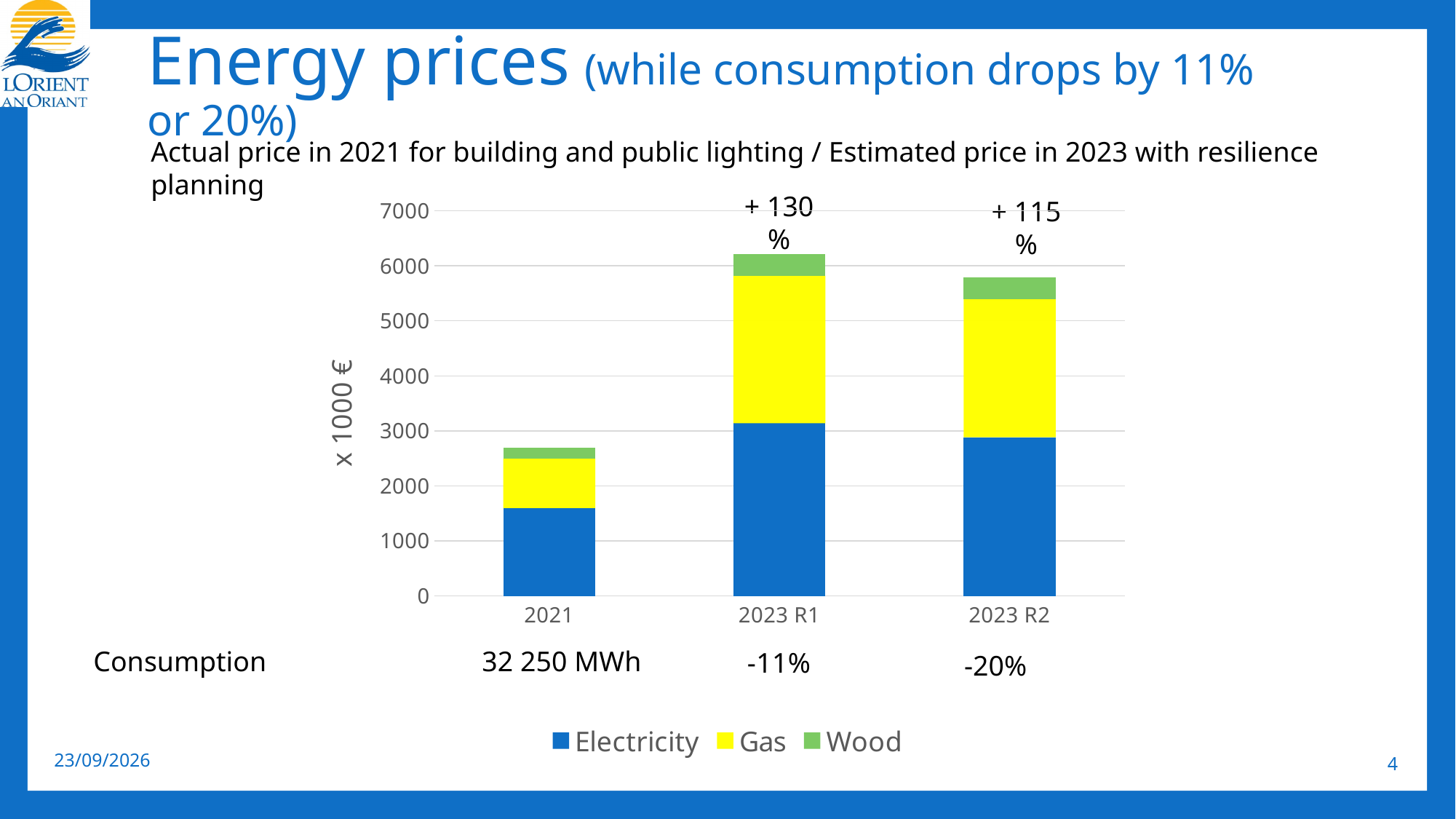
What percentage increase is printed above the 2023 R1 bar? + 130 % Is the total bar for 2023 R2 greater or less than 6000? less Which category has the lowest total bar? 2021 Which category has the highest total bar? 2023 R1 Is the Electricity value for 2021 greater or less than 2000? less What is the label on the vertical axis of the chart? x 1000 € How many categories are shown on the x axis of the chart? 3 Which has the larger total bar, 2023 R1 or 2023 R2? 2023 R1 How many series does the chart legend list? 3 Is the total bar for 2023 R1 greater or less than 6000? greater What kind of chart is shown on the slide? Stacked bar chart